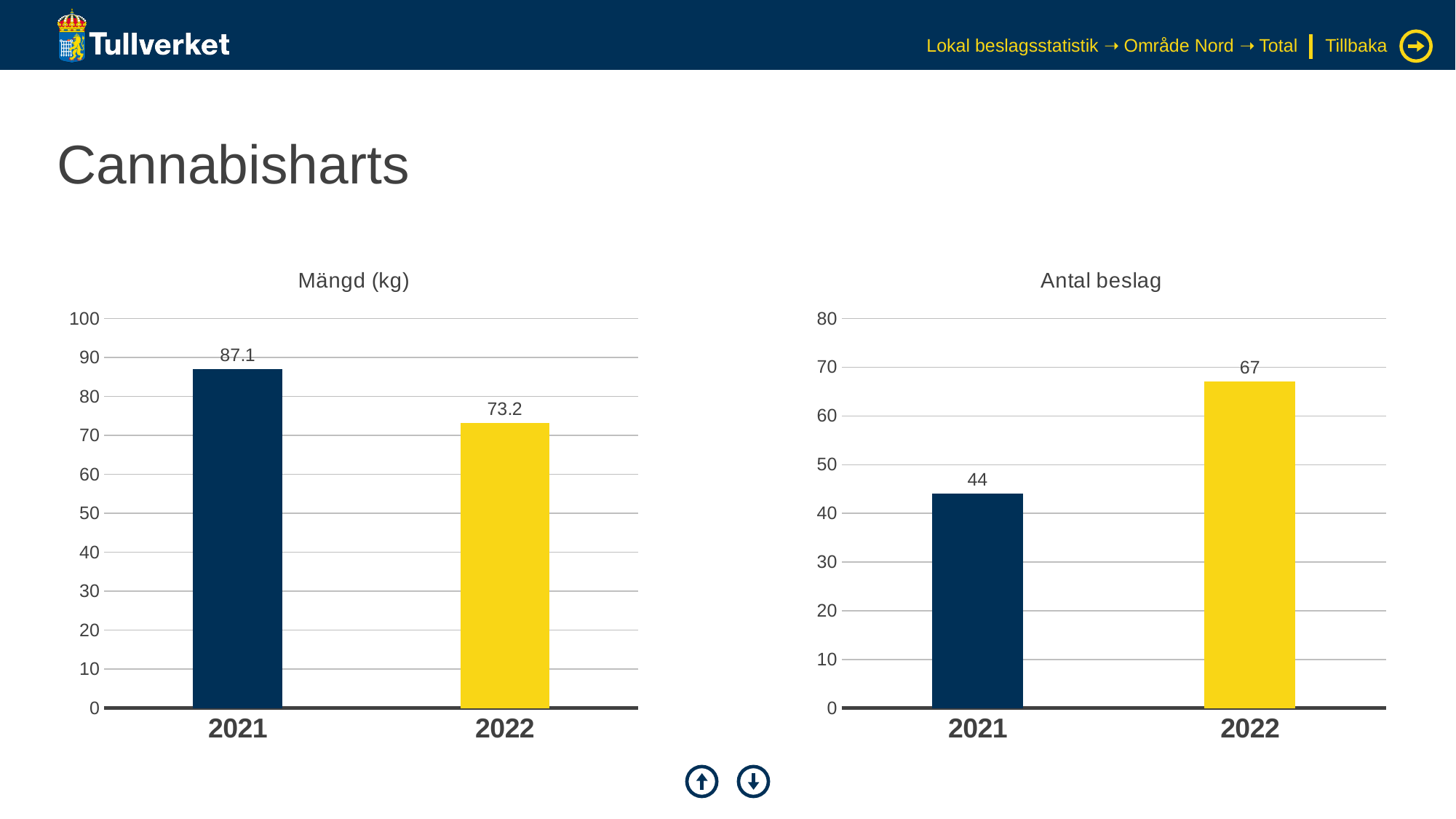
What kind of chart is the 'Antal beslag' chart? bar chart In the 'Antal beslag' chart, what is the value for 2021? 44 In the 'Antal beslag' chart, is the value for 2022 greater or less than 60? greater In the 'Antal beslag' chart, do the values rise or fall from 2021 to 2022? rise In the 'Mängd (kg)' chart, which year has the highest value? 2021 In the 'Antal beslag' chart, which year has the lowest value? 2021 In the 'Antal beslag' chart, what is the value for 2022? 67 How many categories are shown on the x axis of the 'Mängd (kg)' chart? 2 In the 'Antal beslag' chart, what is the difference between the 2022 and 2021 values? 23 In the 'Mängd (kg)' chart, what is the value for 2021? 87.1 In the 'Mängd (kg)' chart, what is the difference between the 2021 and 2022 values? 13.9 In the 'Mängd (kg)' chart, what is the value for 2022? 73.2